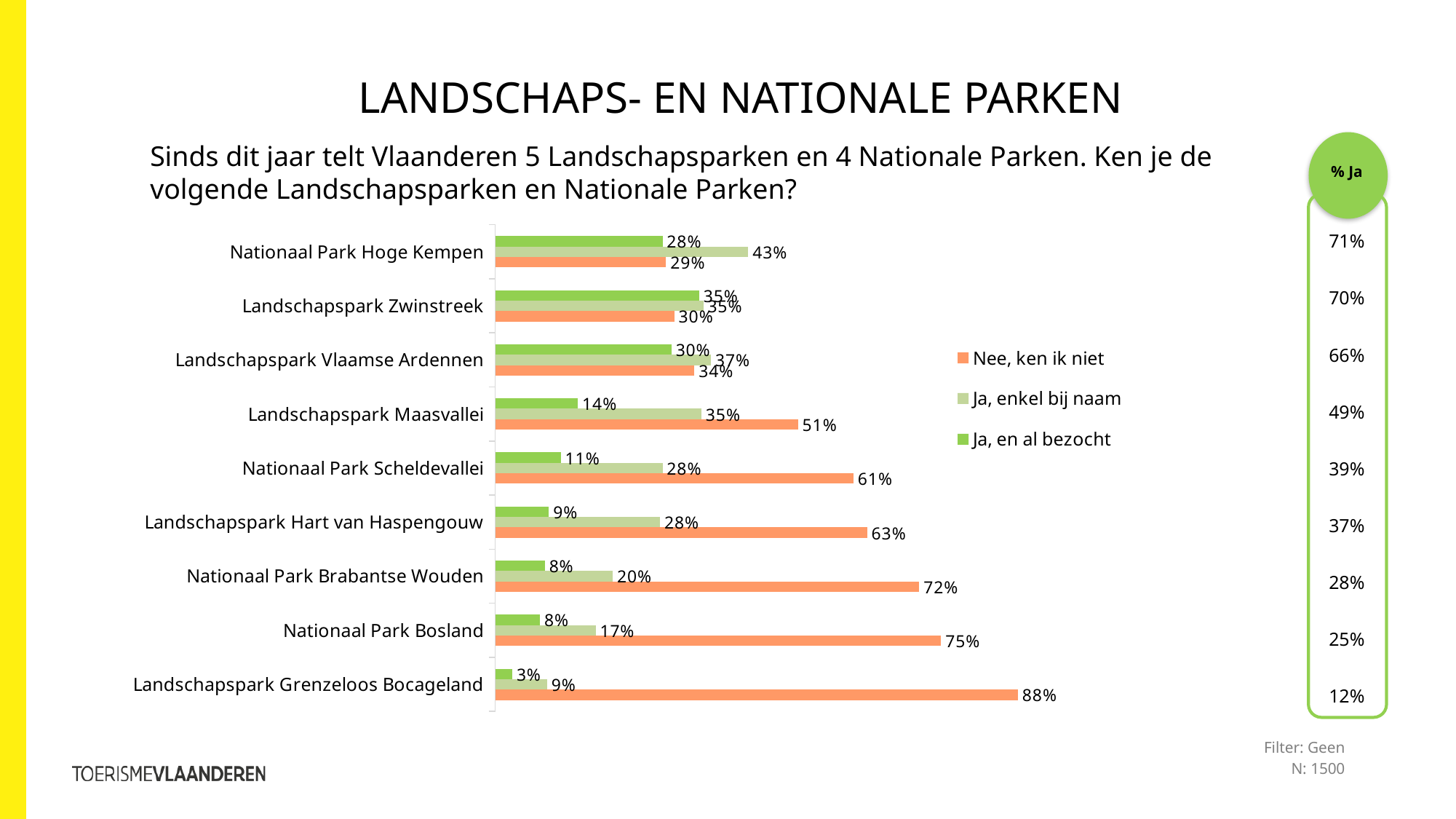
How many series does the chart legend list? 3 What is the difference between the 'Nee, ken ik niet' value and the 'Ja, enkel bij naam' value for Nationaal Park Bosland? 58 percentage points What is the 'Nee, ken ik niet' value for Landschapspark Grenzeloos Bocageland? 88% What kind of chart is shown on the slide? bar chart Which legend entry is shown in orange? Nee, ken ik niet What is the 'Ja, enkel bij naam' value for Nationaal Park Hoge Kempen? 43% Which is larger for Nationaal Park Scheldevallei: the 'Nee, ken ik niet' value or the 'Ja, enkel bij naam' value? Nee, ken ik niet Which park has the lowest 'Ja, en al bezocht' value? Landschapspark Grenzeloos Bocageland What is the 'Ja, en al bezocht' value for Landschapspark Maasvallei? 14% Which park has the highest 'Nee, ken ik niet' value? Landschapspark Grenzeloos Bocageland What is the '% Ja' value shown for Landschapspark Zwinstreek in the side panel? 70% How many parks (categories) are listed in the chart? 9